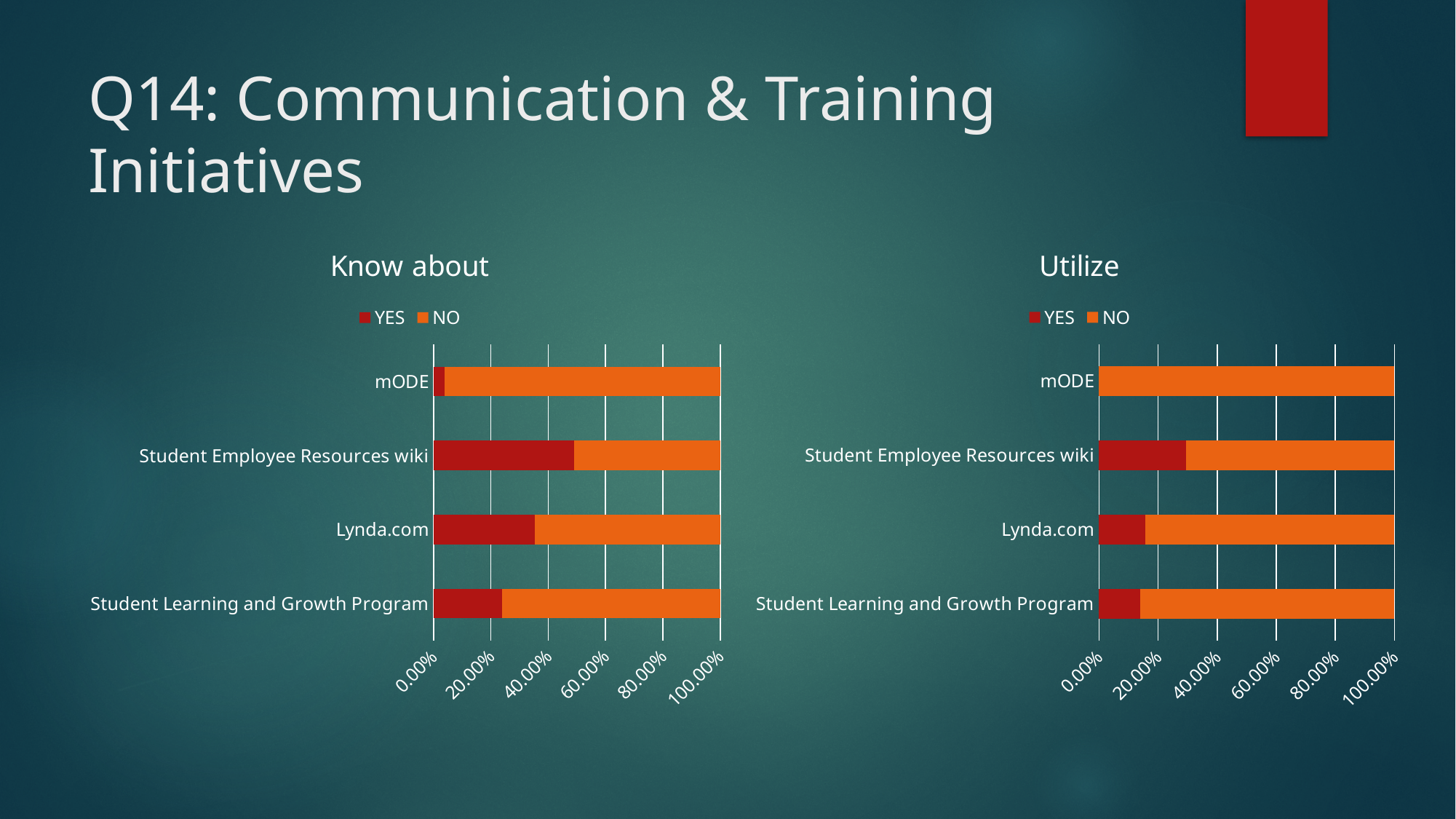
In the "Know about" chart, which category has the largest YES share? Student Employee Resources wiki In the "Know about" chart, which category has the smallest YES share? mODE What kind of chart is the "Know about" chart? bar chart What are the two legend entries on the "Utilize" chart? YES and NO In the "Utilize" chart, which category has the largest YES share? Student Employee Resources wiki In the "Know about" chart, which has the larger YES share, Lynda.com or Student Learning and Growth Program? Lynda.com In the "Utilize" chart, is the YES value for Lynda.com greater or less than 20.00%? less In the "Know about" chart, is the YES value for Student Employee Resources wiki greater or less than 40.00%? greater In the "Know about" chart, is the YES value for Lynda.com greater or less than 40.00%? less How many series does the legend of the "Know about" chart list? 2 How many categories are shown on the "Utilize" chart? 4